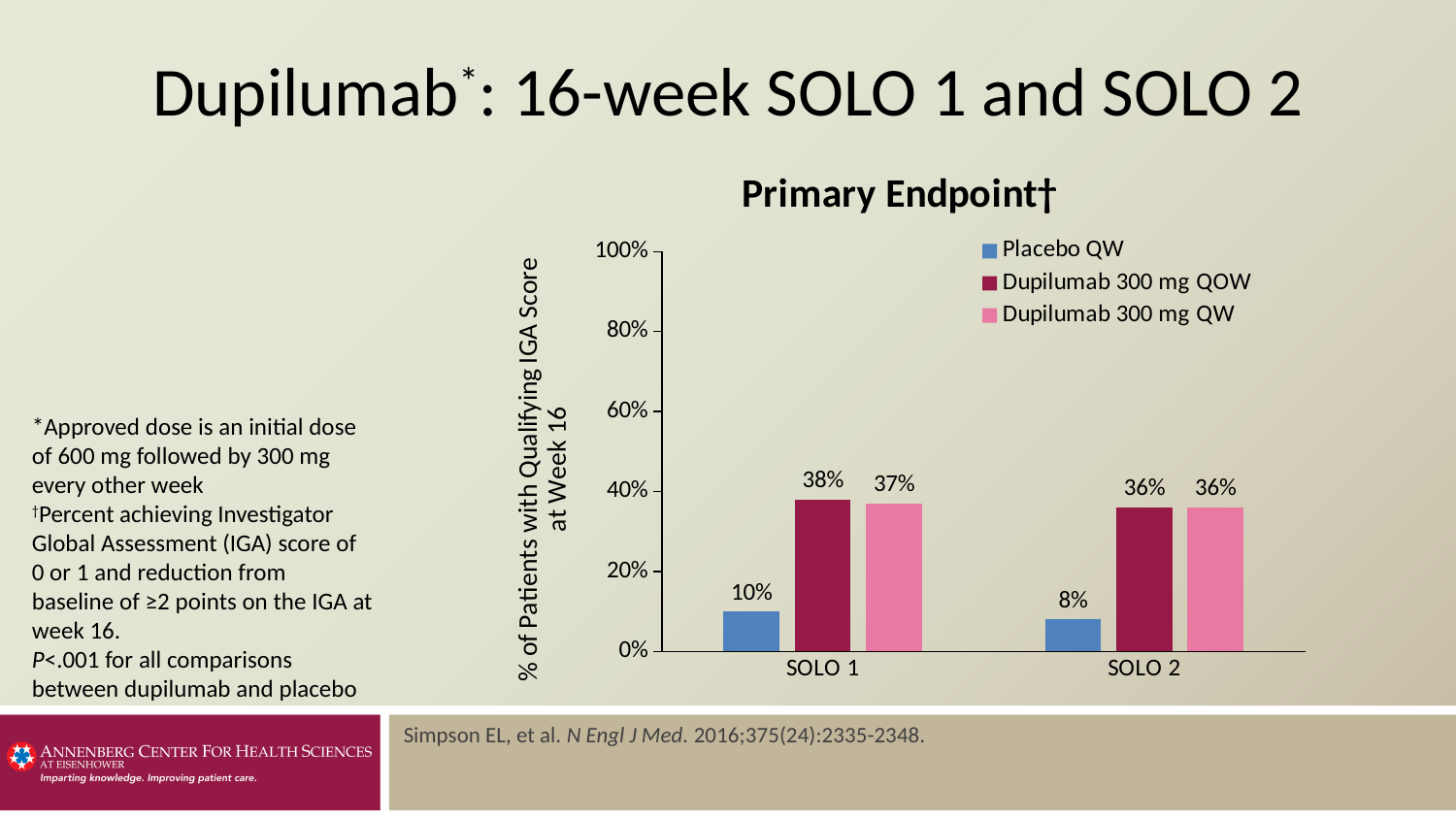
Which series has the lowest value in SOLO 1? Placebo QW Which series has the highest value in SOLO 1? Dupilumab 300 mg QOW What is the title of the chart? Primary Endpoint† What kind of chart is shown? Bar chart What is the value for Placebo QW in SOLO 1? 10% Which is larger: Placebo QW in SOLO 1 or Placebo QW in SOLO 2? Placebo QW in SOLO 1 How many series does the legend list? 3 What is the difference between Dupilumab 300 mg QW and Placebo QW in SOLO 2? 28% What is the difference between Dupilumab 300 mg QOW and Placebo QW in SOLO 1? 28% What is the value for Dupilumab 300 mg QW in SOLO 1? 37% What is the value for Dupilumab 300 mg QOW in SOLO 2? 36% What is the value for Placebo QW in SOLO 2? 8%